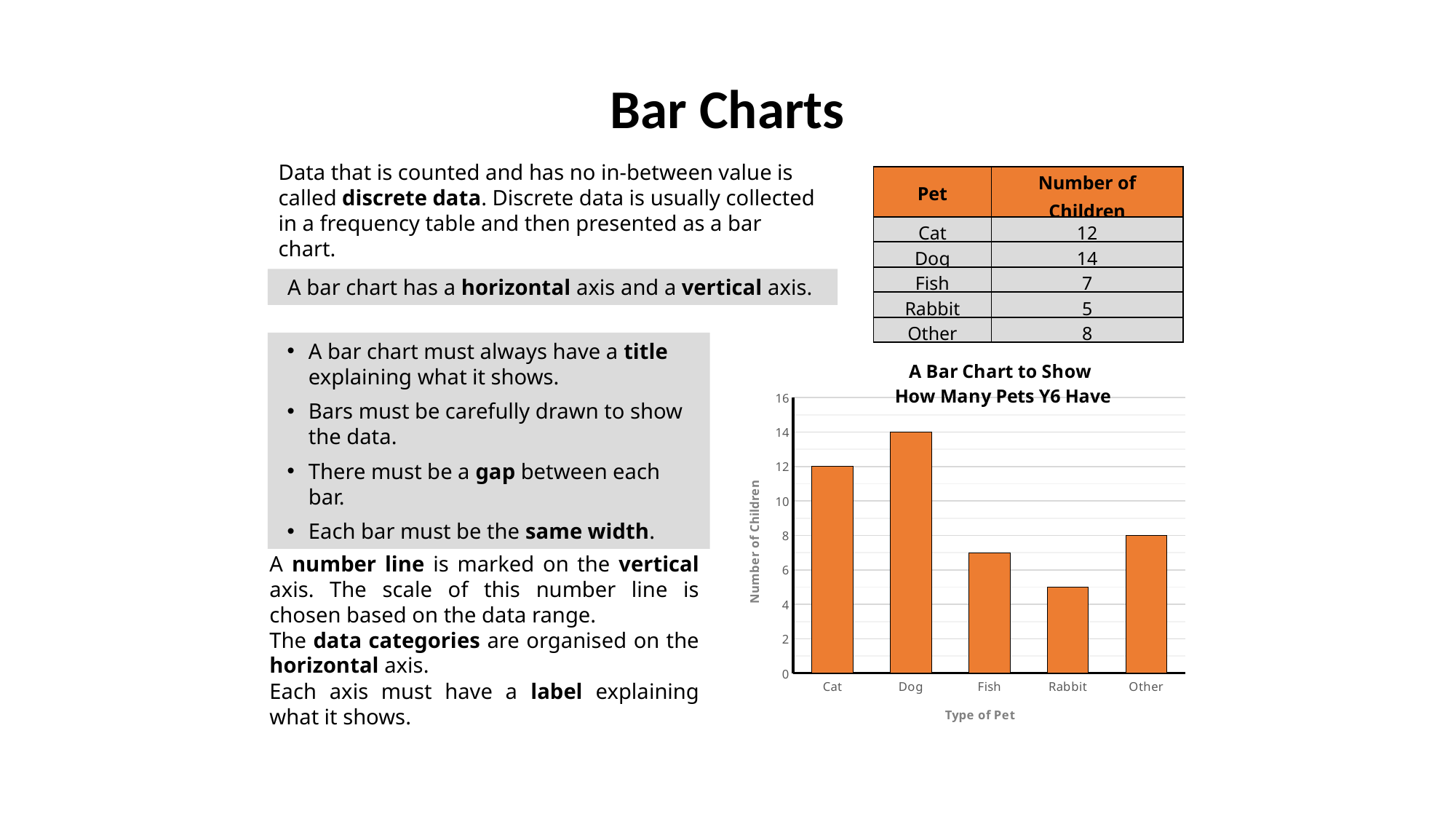
What is the title of the chart? A Bar Chart to Show How Many Pets Y6 Have What is the label on the horizontal axis of the chart? Type of Pet Which pet has the highest number of children? Dog What type of chart is shown on the slide? bar chart Which pet has the lowest number of children? Rabbit What is the difference between the number of children for Dog and Cat? 2 Is the value for Fish greater or less than 8? less What is the number of children for Dog? 14 How many pet categories are shown on the chart? 5 What is the number of children for Cat? 12 Which has more children, Fish or Other? Other What is the number of children for Other? 8